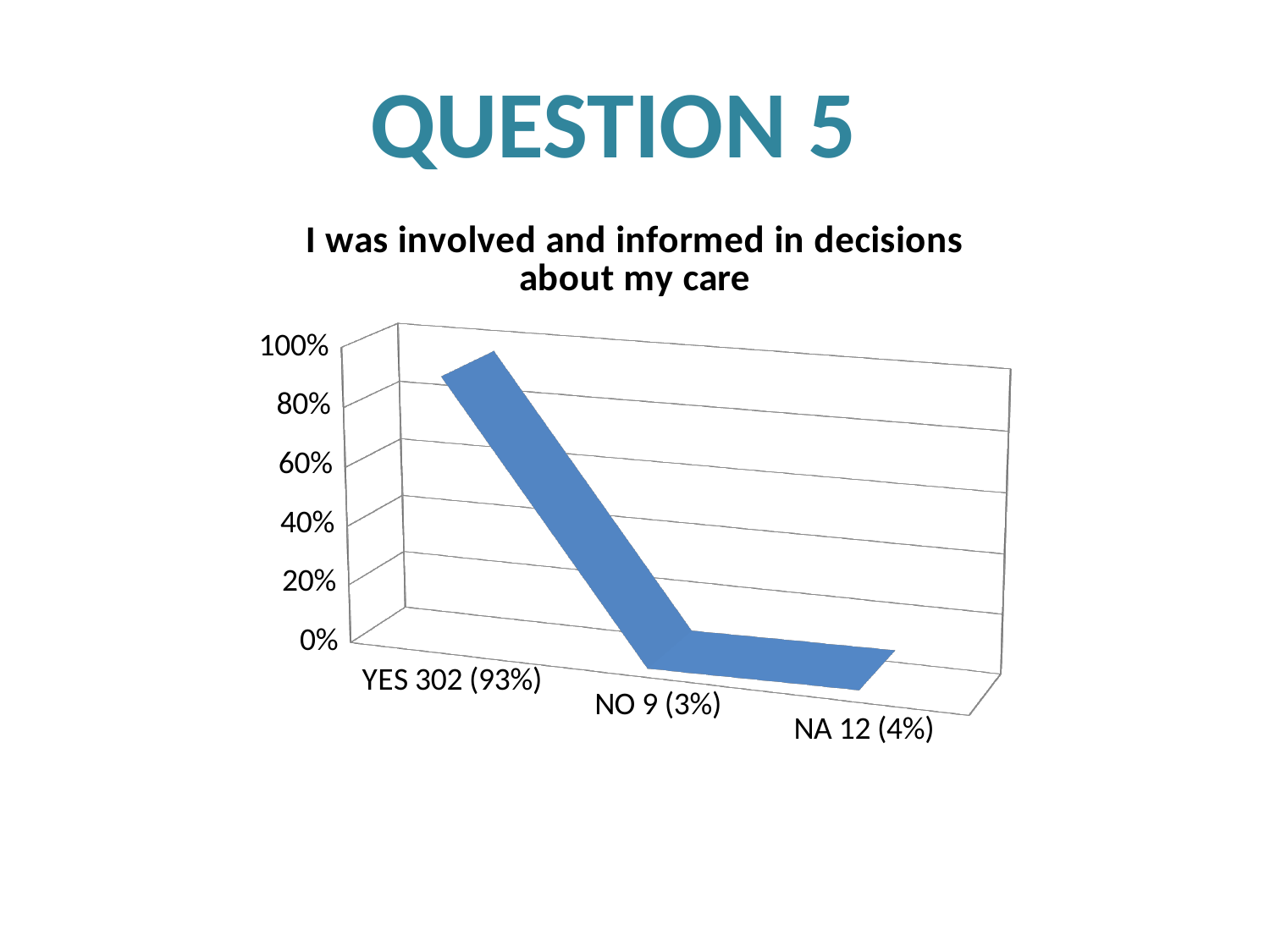
What is the title of the chart? I was involved and informed in decisions about my care How many categories are plotted along the x axis? 3 What kind of chart is shown on the slide? line chart Do the values rise or fall from YES to NO along the x axis? fall What percentage is shown for the NA category? 4% What percentage is shown for the NO category? 3% Which category has the lowest value? NO What is the difference in percentage between the YES and NA categories? 89% How many responses does the NA category label show? 12 Which category has the highest value? YES What percentage is shown for the YES category? 93% How many responses does the YES category label show? 302